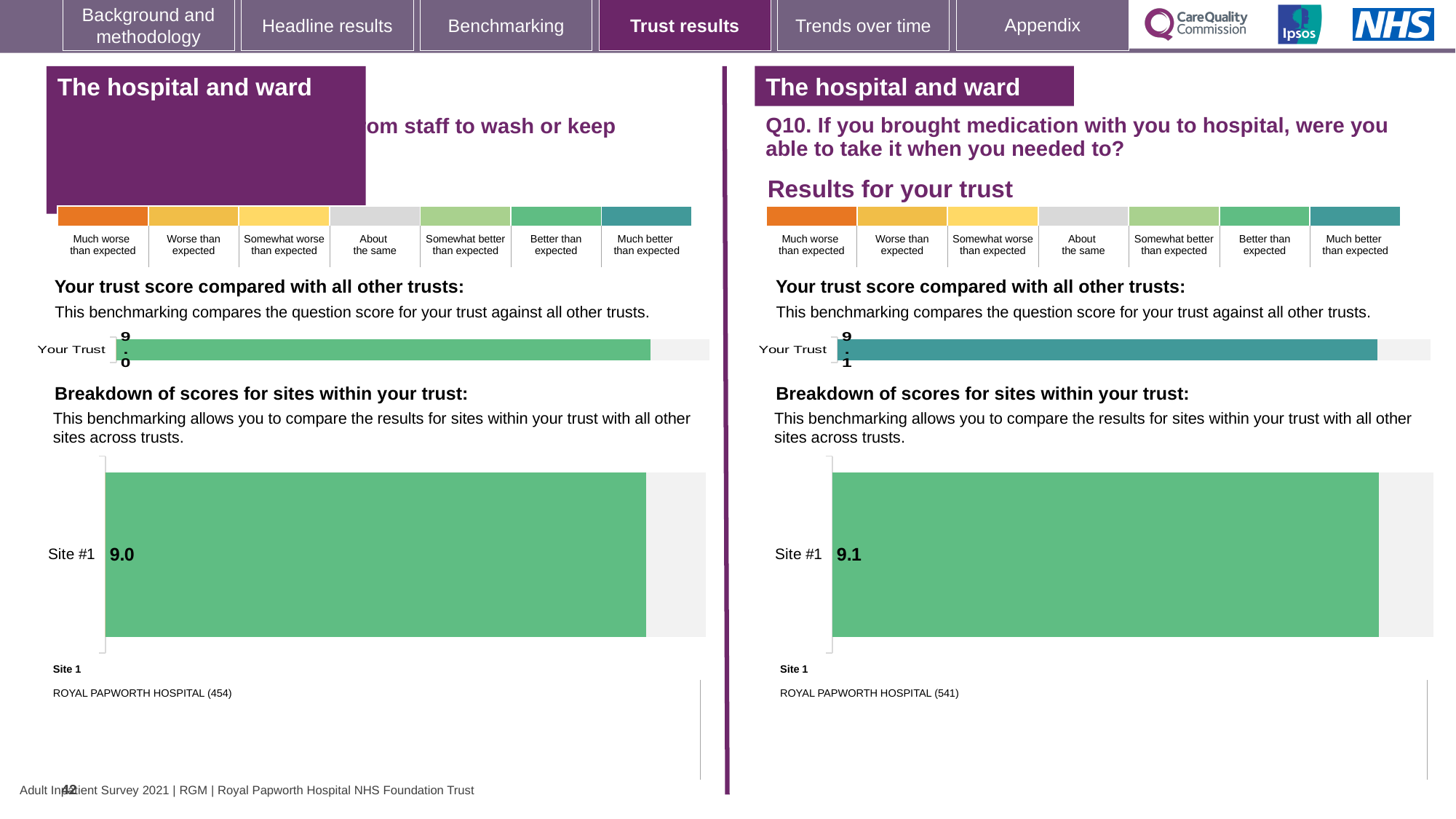
On the right half of the slide (Q10), in the 'Breakdown of scores for sites within your trust' chart, what is the value for Site #1? 9.1 What is the difference between the Your Trust value in the right-hand (Q10) trust score chart and the Your Trust value in the left-hand trust score chart? 0.1 How many sites are plotted in the 'Breakdown of scores for sites within your trust' chart on the right half of the slide? 1 On the left half of the slide, in the 'Your trust score compared with all other trusts' chart, what is the value for Your Trust? 9.0 In the 'Breakdown of scores for sites within your trust' chart on the right half of the slide, which site is labelled as Site 1? ROYAL PAPWORTH HOSPITAL (541) Which is larger: the Site #1 value in the left-hand site breakdown chart or the Site #1 value in the right-hand (Q10) site breakdown chart? the right-hand (Q10) chart, 9.1 What kind of chart is the 'Breakdown of scores for sites within your trust' chart on the right half of the slide? bar chart What kind of chart is the 'Your trust score compared with all other trusts' chart on the left half of the slide? bar chart In the 'Breakdown of scores for sites within your trust' chart on the left half of the slide, which site is labelled as Site 1? ROYAL PAPWORTH HOSPITAL (454) On the right half of the slide (Q10), in the 'Your trust score compared with all other trusts' chart, what is the value for Your Trust? 9.1 How many sites are plotted in the 'Breakdown of scores for sites within your trust' chart on the left half of the slide? 1 On the left half of the slide, in the 'Breakdown of scores for sites within your trust' chart, what is the value for Site #1? 9.0